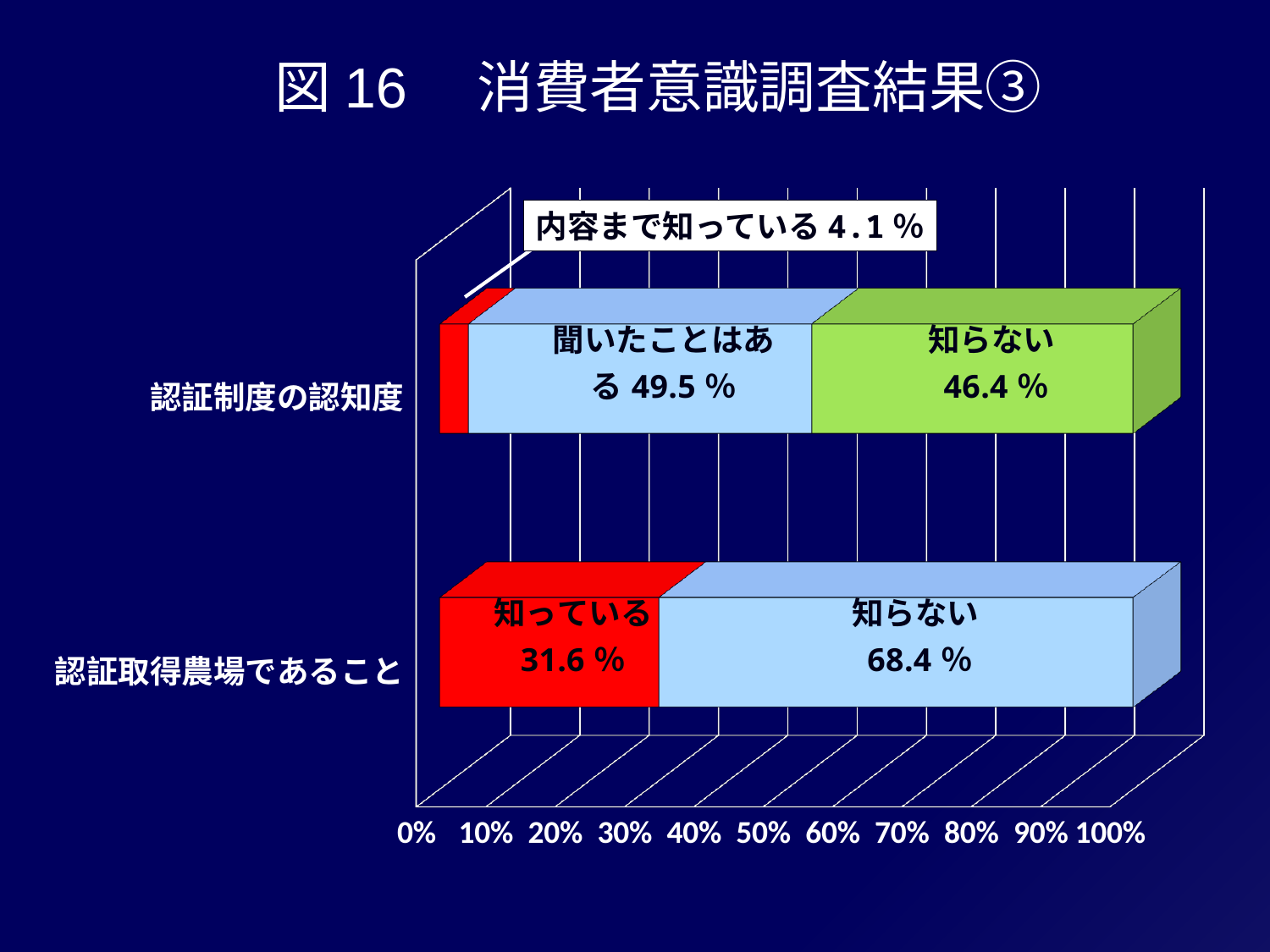
Which segment is the largest in the 認証制度の認知度 bar? 聞いたことはある For 認証取得農場であること, what is the difference between the 知らない and 知っている percentages? 36.8% What percentage of respondents answered 知っている for 認証取得農場であること? 31.6% What percentage of respondents answered 知らない for 認証取得農場であること? 68.4% Which segment is the smallest in the 認証制度の認知度 bar? 内容まで知っている What percentage of respondents answered 知らない for 認証制度の認知度? 46.4% What is the title of the slide? 図16 消費者意識調査結果③ How many categories (bars) does the chart show? 2 What kind of chart is shown on the slide? Stacked bar chart What percentage of respondents answered 内容まで知っている for 認証制度の認知度? 4.1% What percentage of respondents answered 聞いたことはある for 認証制度の認知度? 49.5% Which is larger: the 知らない share for 認証取得農場であること or the 知らない share for 認証制度の認知度? 認証取得農場であること